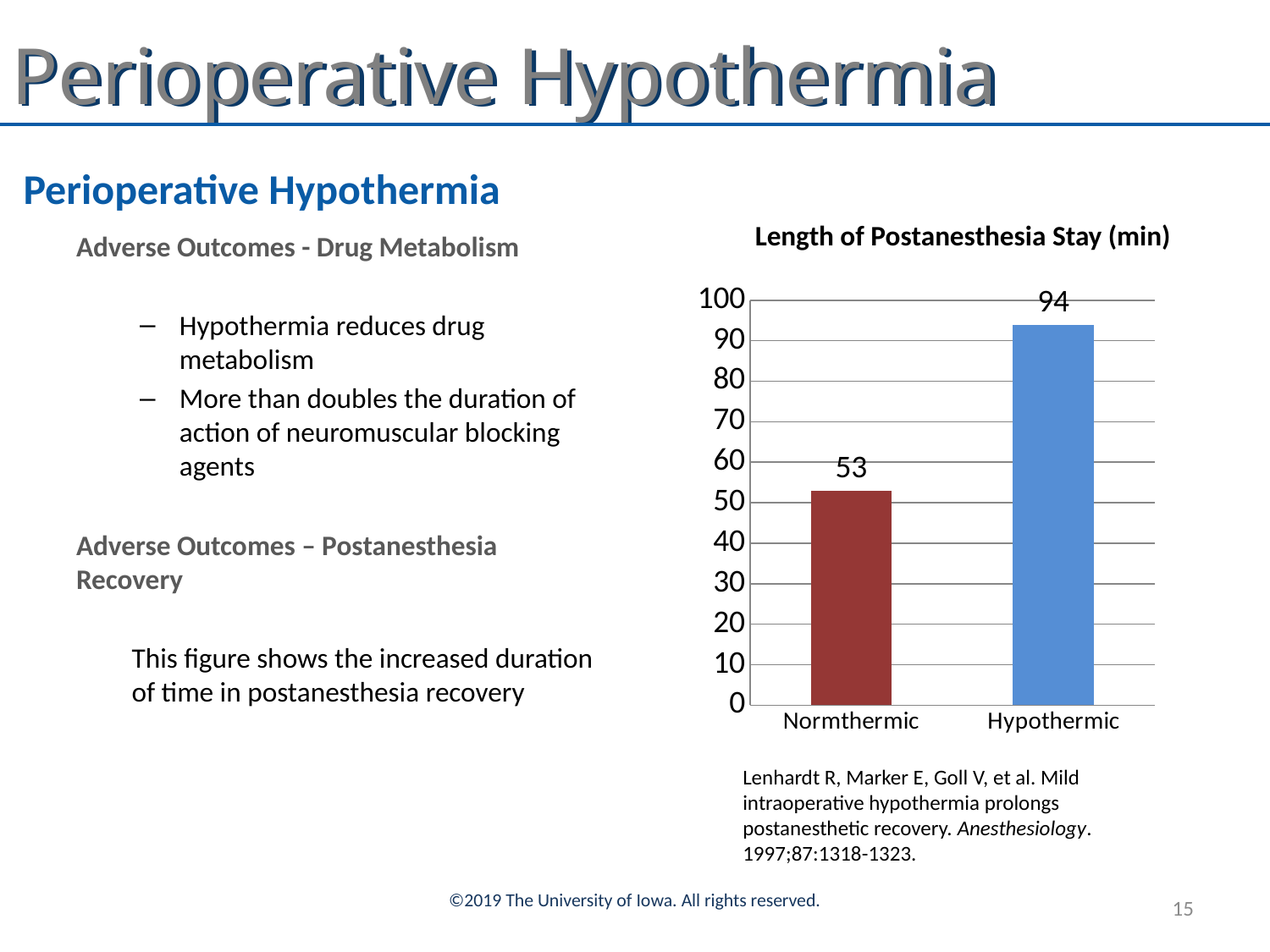
Which is larger, the value for Normthermic or the value for Hypothermic? Hypothermic What is the difference between the Hypothermic and Normthermic values? 41 Is the value for Hypothermic greater or less than 90? greater What kind of chart is shown on the slide? bar chart What is the title of the chart? Length of Postanesthesia Stay (min) What colour is the Hypothermic bar? blue How many categories are shown in the chart? 2 Which category has the highest value in the chart? Hypothermic Which category has the lowest value in the chart? Normthermic What is the value for Hypothermic in the Length of Postanesthesia Stay chart? 94 Is the value for Normthermic greater or less than 60? less What is the value for Normthermic in the Length of Postanesthesia Stay chart? 53